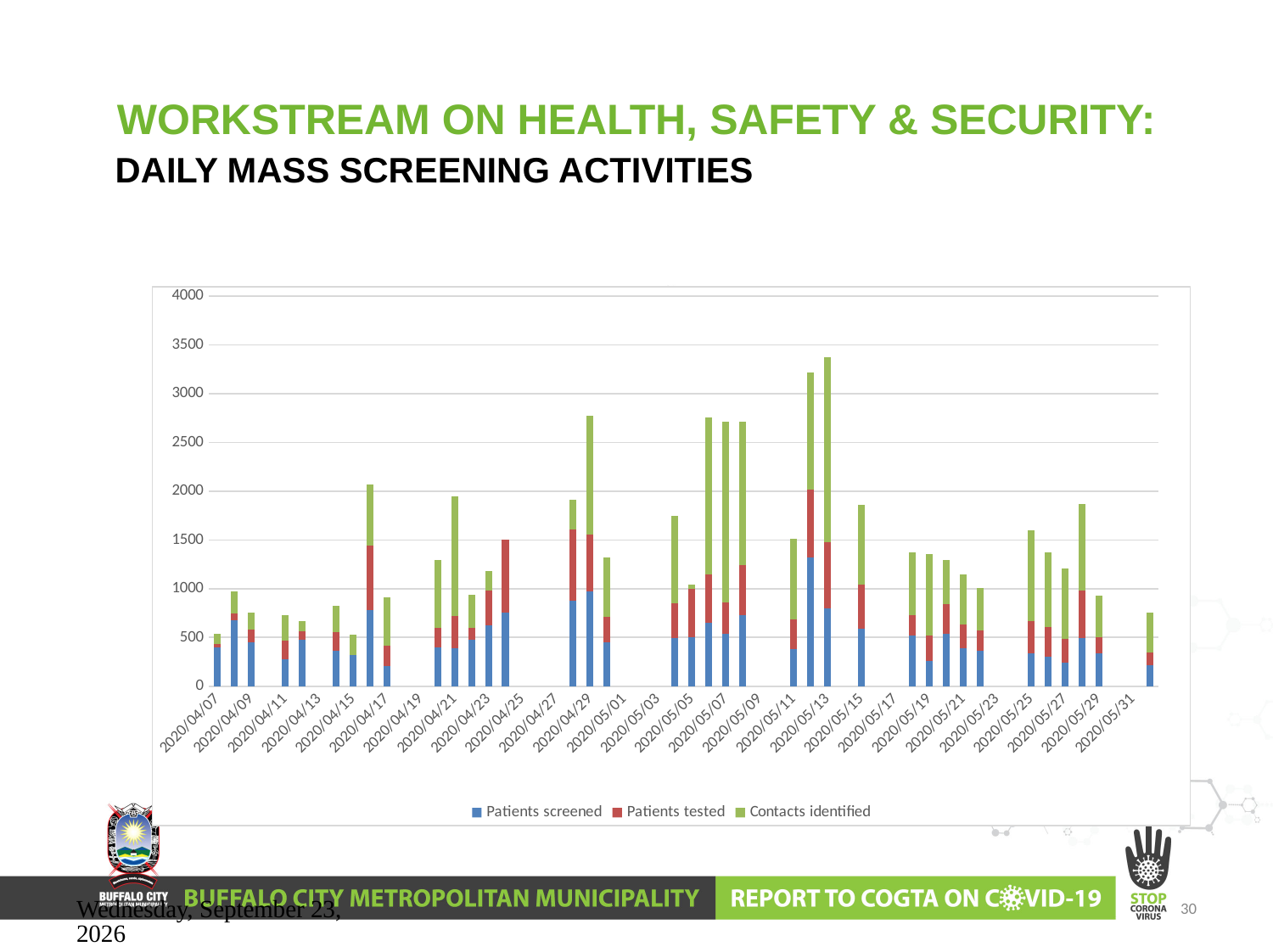
Is the total stacked value for 2020/05/29 greater or less than 1000? less How many series does the chart legend list? 3 Which date has the taller stacked bar, 2020/04/07 or 2020/04/29? 2020/04/29 What are the three series named in the chart legend? Patients screened, Patients tested, Contacts identified Is the total stacked value for 2020/05/15 greater or less than 1500? greater Is the total stacked value for 2020/04/21 greater or less than 1500? greater Which colour represents Contacts identified in the chart? Green What kind of chart is shown on the slide? Stacked bar chart